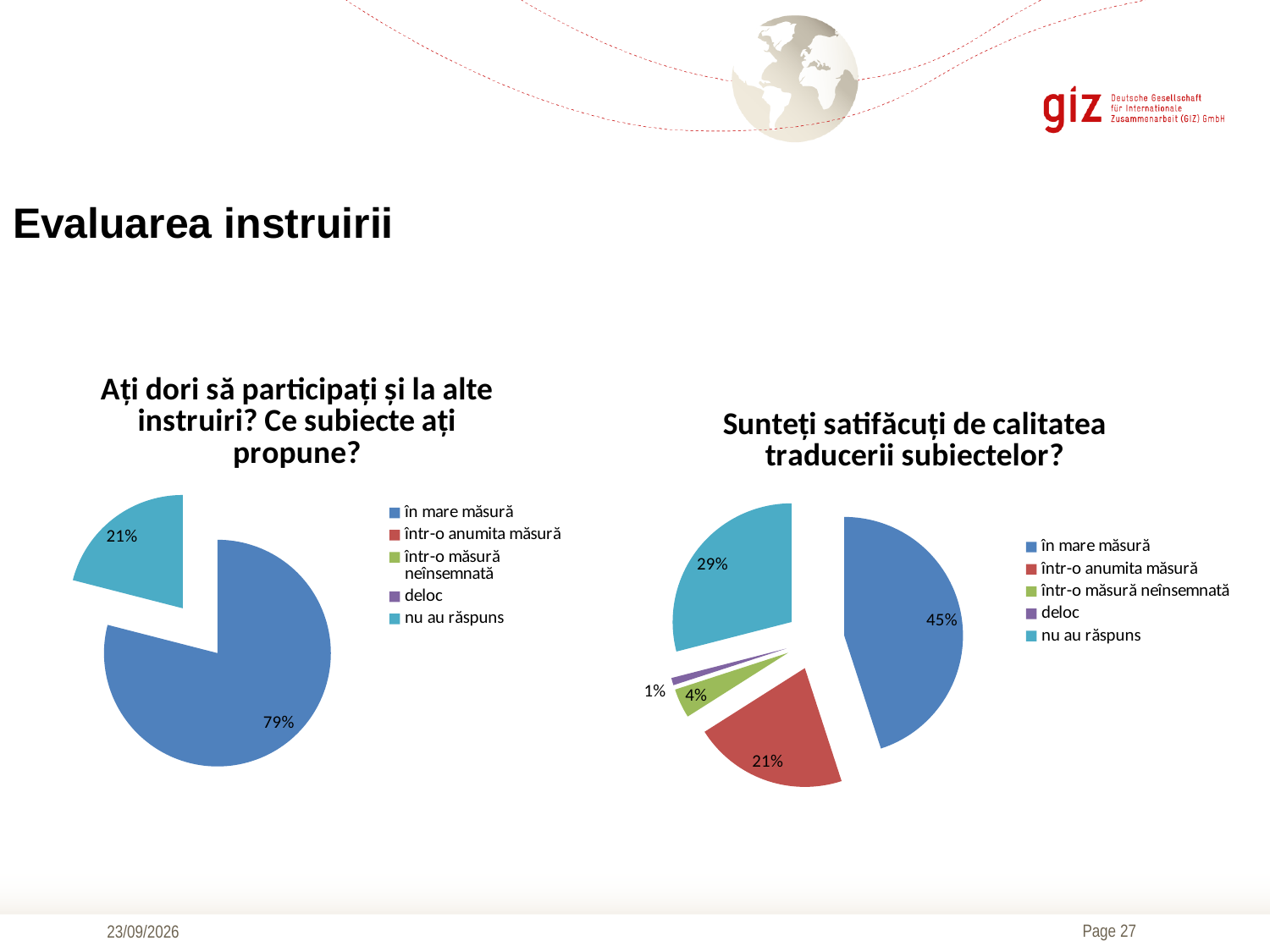
In the right pie chart ("Sunteți satisfăcuți de calitatea traducerii subiectelor?"), which category has the smallest slice? deloc In the right pie chart ("Sunteți satisfăcuți de calitatea traducerii subiectelor?"), what is the difference between the "în mare măsură" share and the "într-o anumita măsură" share? 24% In the left pie chart ("Ați dori să participați și la alte instruiri?"), what share is labelled for "în mare măsură"? 79% In the right pie chart ("Sunteți satisfăcuți de calitatea traducerii subiectelor?"), what share is labelled for "în mare măsură"? 45% How many entries does the legend of the right pie chart ("Sunteți satisfăcuți de calitatea traducerii subiectelor?") list? 5 In the left pie chart ("Ați dori să participați și la alte instruiri?"), what is the difference between the "în mare măsură" share and the "nu au răspuns" share? 58% In the left pie chart ("Ați dori să participați și la alte instruiri?"), which category has the largest slice? în mare măsură In the right pie chart ("Sunteți satisfăcuți de calitatea traducerii subiectelor?"), what share is labelled for "deloc"? 1% What kind of chart is used on the left of the slide, titled "Ați dori să participați și la alte instruiri? Ce subiecte ați propune?"? Pie chart In the right pie chart ("Sunteți satisfăcuți de calitatea traducerii subiectelor?"), which is larger: "într-o anumita măsură" or "într-o măsură neînsemnată"? într-o anumita măsură